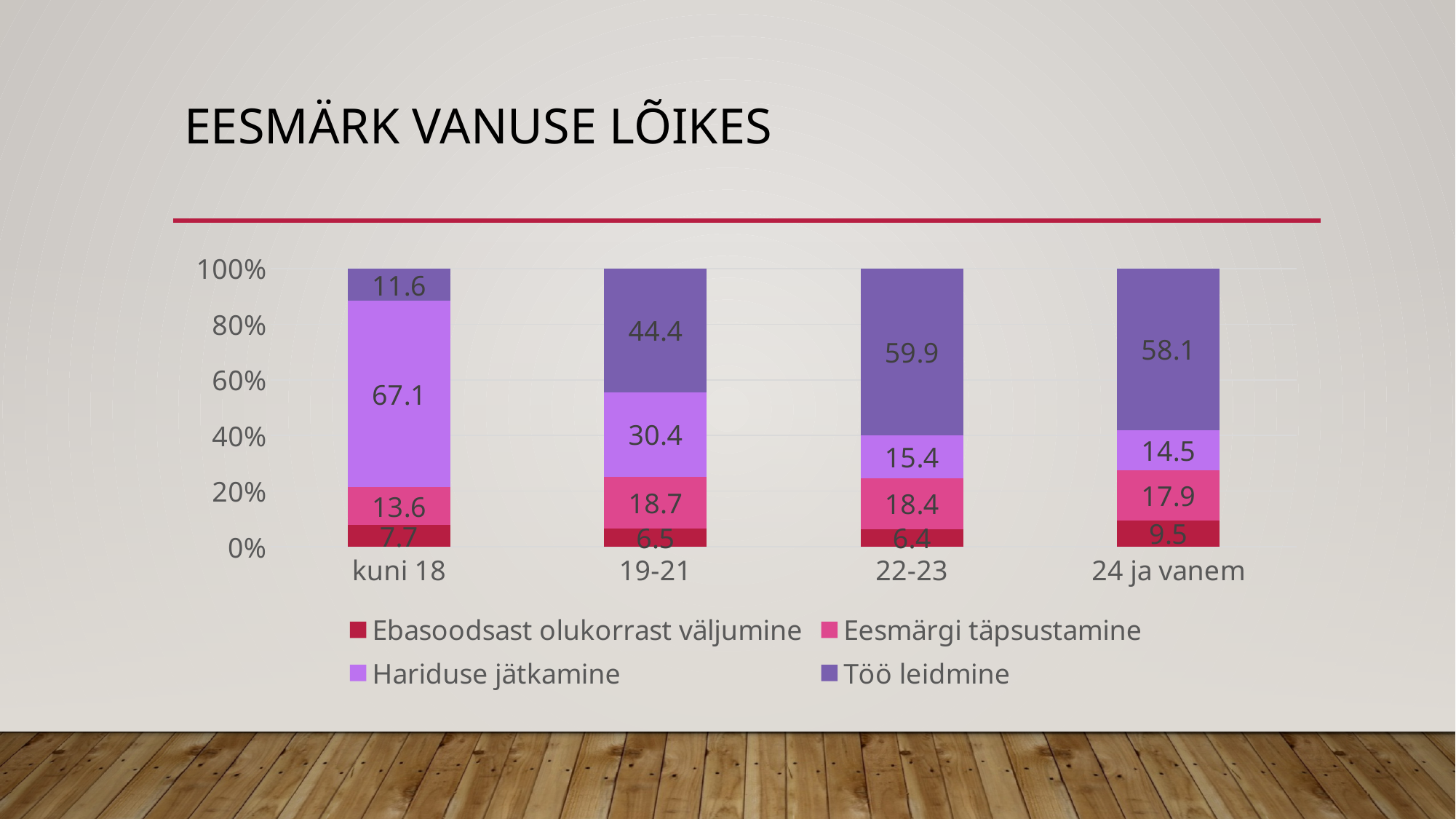
What is the title of the slide? EESMÄRK VANUSE LÕIKES What kind of chart is shown on the slide? Stacked bar chart What is the value of Hariduse jätkamine for the kuni 18 age group? 67.1 What is the difference between the Hariduse jätkamine values for kuni 18 and 19-21? 36.7 What is the value of Töö leidmine for the 22-23 age group? 59.9 Does the value of Hariduse jätkamine rise or fall as the age groups go from kuni 18 to 24 ja vanem? Fall Which age group has the highest value for Töö leidmine? 22-23 How many series does the legend list? 4 Which age group has the lowest value for Ebasoodsast olukorrast väljumine? 22-23 For the 19-21 age group, which is larger: Töö leidmine or Hariduse jätkamine? Töö leidmine What is the value of Eesmärgi täpsustamine for the 19-21 age group? 18.7 How many age groups are shown on the x axis? 4